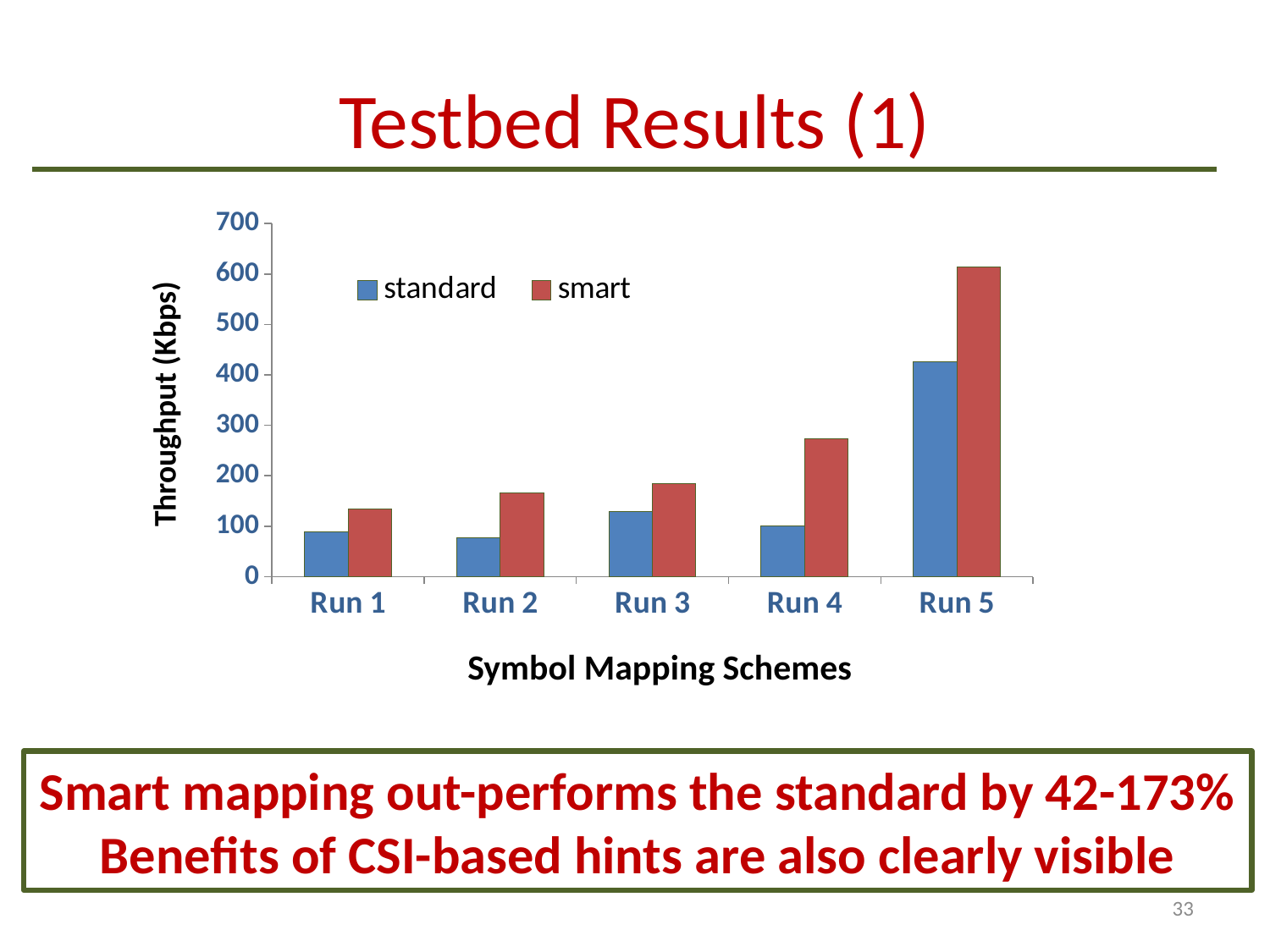
Is the smart throughput for Run 5 greater or less than 500? greater Is the smart throughput for Run 4 greater or less than 200? greater What is the label of the y axis? Throughput (Kbps) How many series does the chart's legend list? 2 For which run is the standard throughput highest? Run 5 Is the standard throughput for Run 2 greater or less than 100? less What are the two series named in the legend? standard and smart How many runs are shown on the x axis of the chart? 5 For which run is the smart throughput lowest? Run 1 For which run is the smart throughput highest? Run 5 What kind of chart is shown on the slide? bar chart In Run 4, which series has the larger throughput, standard or smart? smart